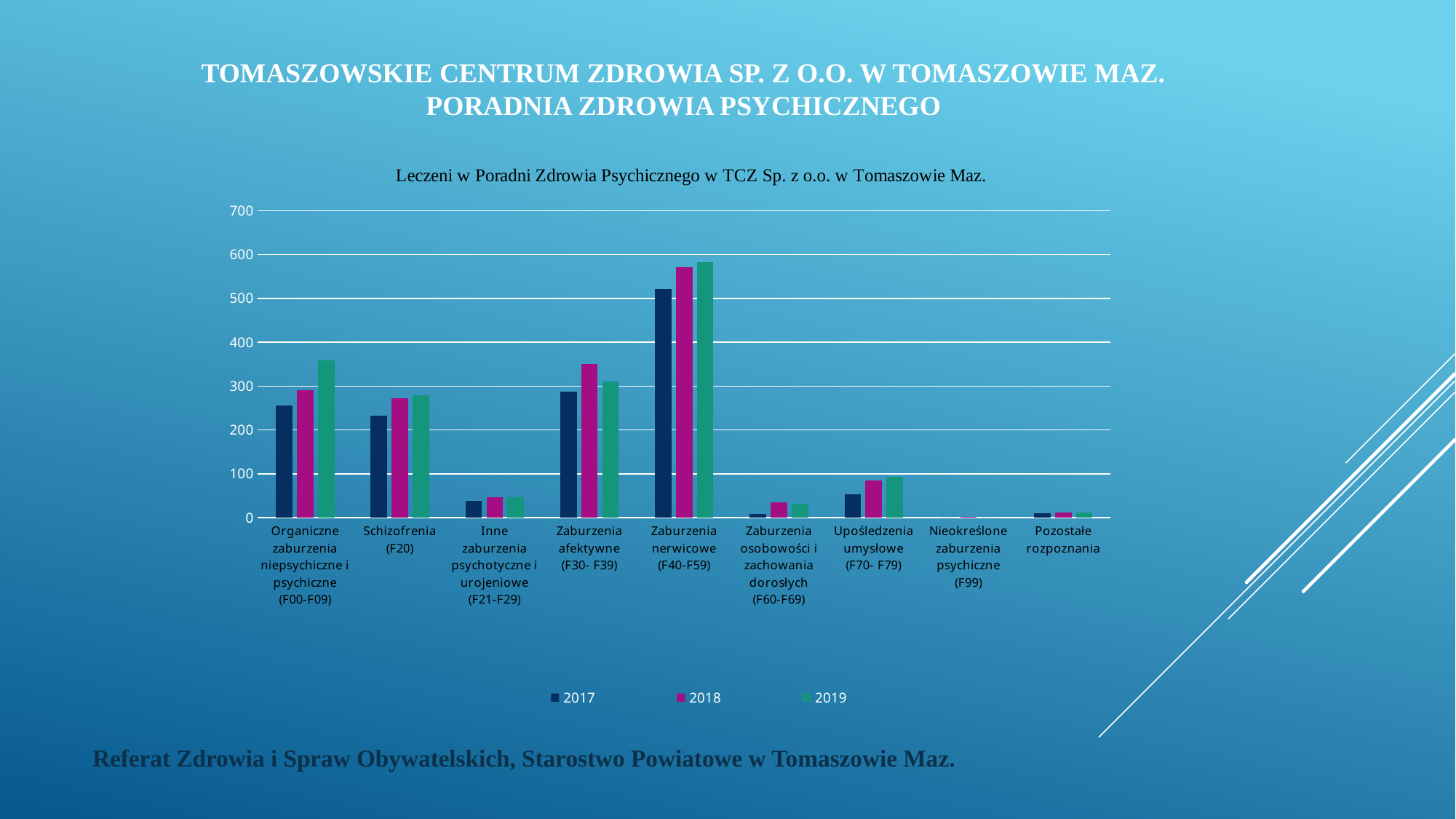
Is the 2019 value for Organiczne zaburzenia niepsychiczne i psychiczne (F00-F09) greater or less than 300? greater Do the values for Organiczne zaburzenia niepsychiczne i psychiczne (F00-F09) rise or fall from 2017 to 2019? rise What are the legend entries of the chart? 2017, 2018, 2019 Is the 2018 value for Zaburzenia afektywne (F30-F39) greater or less than 300? greater What kind of chart is shown on the slide? bar chart How many series does the legend list? 3 Is the 2017 value for Zaburzenia nerwicowe (F40-F59) greater or less than 500? greater For Zaburzenia afektywne (F30-F39), which year has the larger value, 2018 or 2019? 2018 How many categories are shown on the x axis? 9 Which category has the lowest value for 2018? Nieokreślone zaburzenia psychiczne (F99) Which category has the highest value for 2019? Zaburzenia nerwicowe (F40-F59)